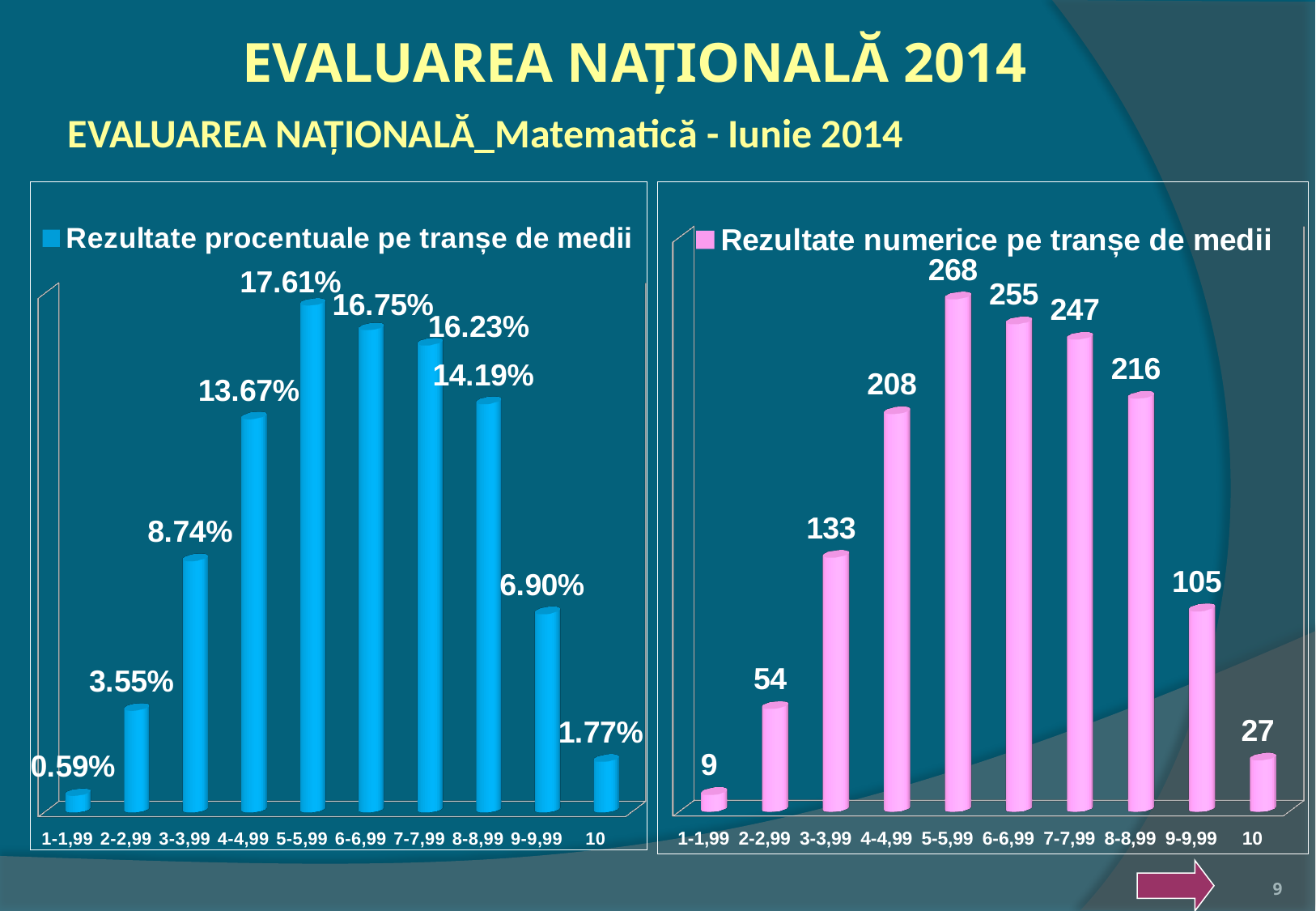
In the right chart (Rezultate numerice pe tranșe de medii), what is the value for the 9-9,99 category? 105 In the left chart (Rezultate procentuale pe tranșe de medii), which is larger: the value for 8-8,99 or the value for 3-3,99? 8-8,99 How many series does the legend of the right chart (Rezultate numerice pe tranșe de medii) list? 1 In the left chart (Rezultate procentuale pe tranșe de medii), which category has the highest value? 5-5,99 In the left chart (Rezultate procentuale pe tranșe de medii), what is the value for the 4-4,99 category? 13.67% What colour are the bars in the right chart (Rezultate numerice pe tranșe de medii)? pink What kind of chart is the left chart (Rezultate procentuale pe tranșe de medii)? bar chart How many categories are shown on the x axis of the right chart (Rezultate numerice pe tranșe de medii)? 10 In the right chart (Rezultate numerice pe tranșe de medii), which category has the lowest value? 1-1,99 In the left chart (Rezultate procentuale pe tranșe de medii), what is the value for the 10 category? 1.77% In the right chart (Rezultate numerice pe tranșe de medii), what is the difference between the values for 6-6,99 and 3-3,99? 122 In the right chart (Rezultate numerice pe tranșe de medii), do the values rise or fall from 5-5,99 to 10? fall